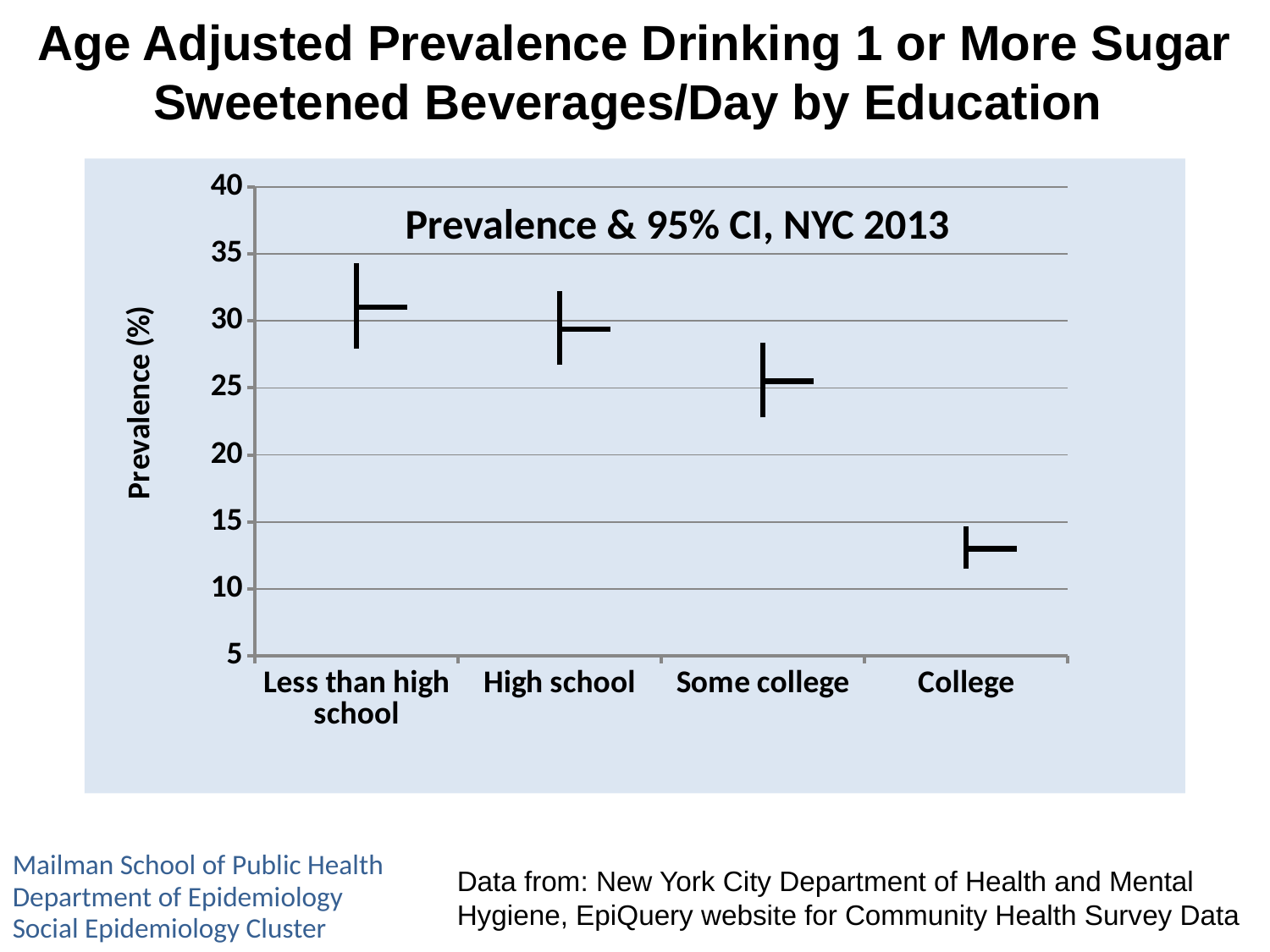
Is the prevalence for College greater or less than 15? less Which has a higher prevalence, College or Less than high school? Less than high school Which education category has the highest prevalence? Less than high school Is the prevalence for Some college greater or less than 30? less How many education categories are shown on the x axis? 4 Is the prevalence for High school greater or less than 25? greater Does prevalence rise or fall as education level increases from left to right? fall Which education category has the lowest prevalence? College What is the label on the y axis? Prevalence (%) Which has a higher prevalence, High school or Some college? High school